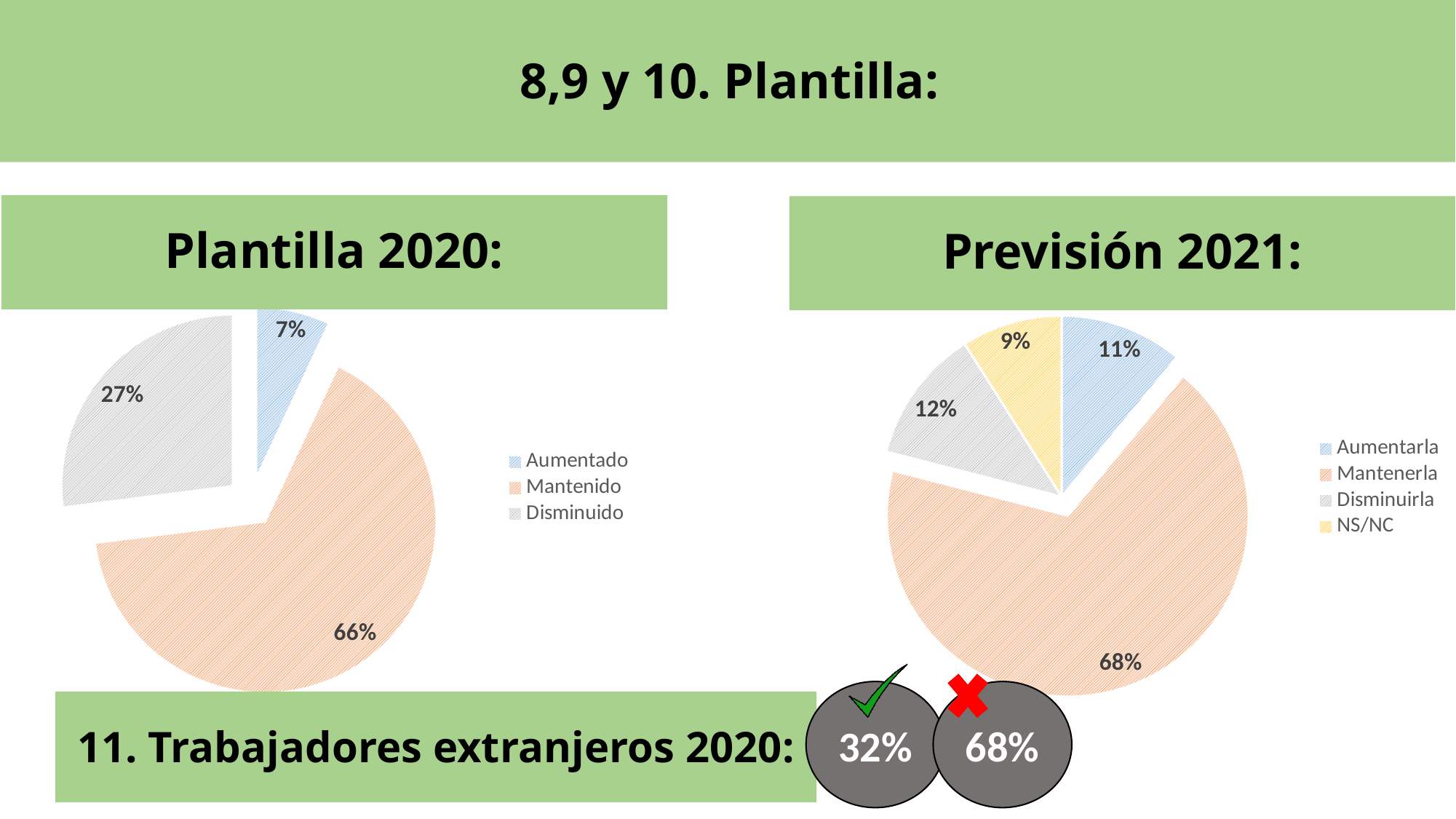
In the Previsión 2021 chart, what colour is the NS/NC slice? Yellow What type of chart is the Plantilla 2020 chart? Pie chart In the Plantilla 2020 chart, what percentage is shown for Mantenido? 66% In the Plantilla 2020 chart, what percentage is shown for Aumentado? 7% In the Previsión 2021 chart, what percentage is shown for Mantenerla? 68% How many categories does the Previsión 2021 chart show? 4 In the Plantilla 2020 chart, what percentage is shown for Disminuido? 27% In the Plantilla 2020 chart, which category has the smallest slice? Aumentado In the Previsión 2021 chart, what percentage is shown for NS/NC? 9% In the Previsión 2021 chart, what is the difference between the Disminuirla and Aumentarla percentages? 1% In the Previsión 2021 chart, which category has the largest slice? Mantenerla In the Plantilla 2020 chart, which is larger, Disminuido or Aumentado? Disminuido